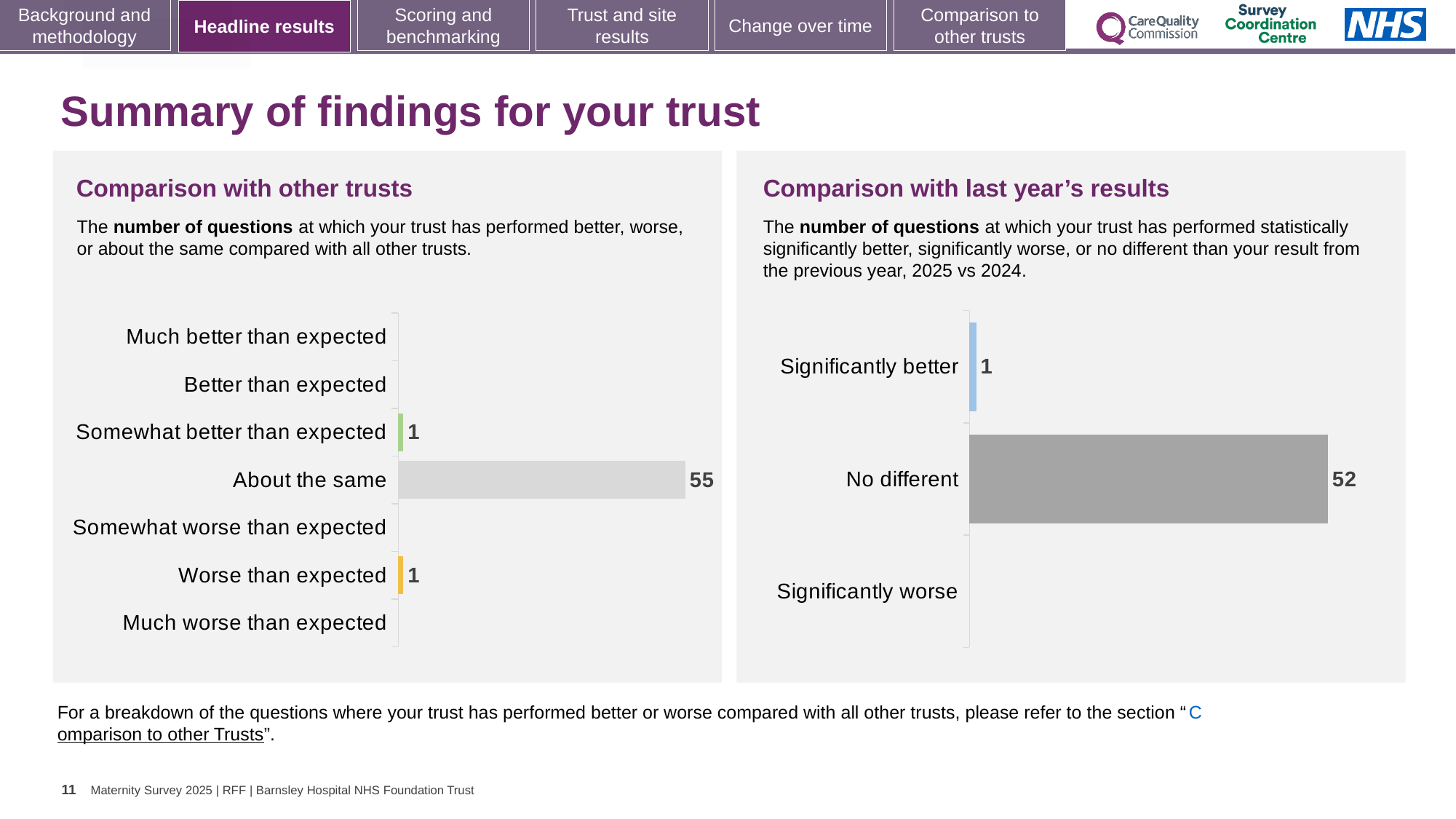
In the 'Comparison with last year's results' chart, what is the value for 'Significantly better'? 1 In the 'Comparison with other trusts' chart, what is the difference between the values for 'About the same' and 'Worse than expected'? 54 How many categories are shown on the y axis of the 'Comparison with other trusts' chart? 7 In the 'Comparison with last year's results' chart, which category has the highest value? No different In the 'Comparison with other trusts' chart, what is the value for 'About the same'? 55 In the 'Comparison with other trusts' chart, which category has the highest value? About the same In the 'Comparison with last year's results' chart, what is the value for 'No different'? 52 What kind of chart is the 'Comparison with other trusts' chart? Bar chart In the 'Comparison with other trusts' chart, what is the value for 'Worse than expected'? 1 In the 'Comparison with last year's results' chart, what is the difference between the values for 'No different' and 'Significantly better'? 51 How many categories are shown on the y axis of the 'Comparison with last year's results' chart? 3 In the 'Comparison with other trusts' chart, what is the value for 'Somewhat better than expected'? 1